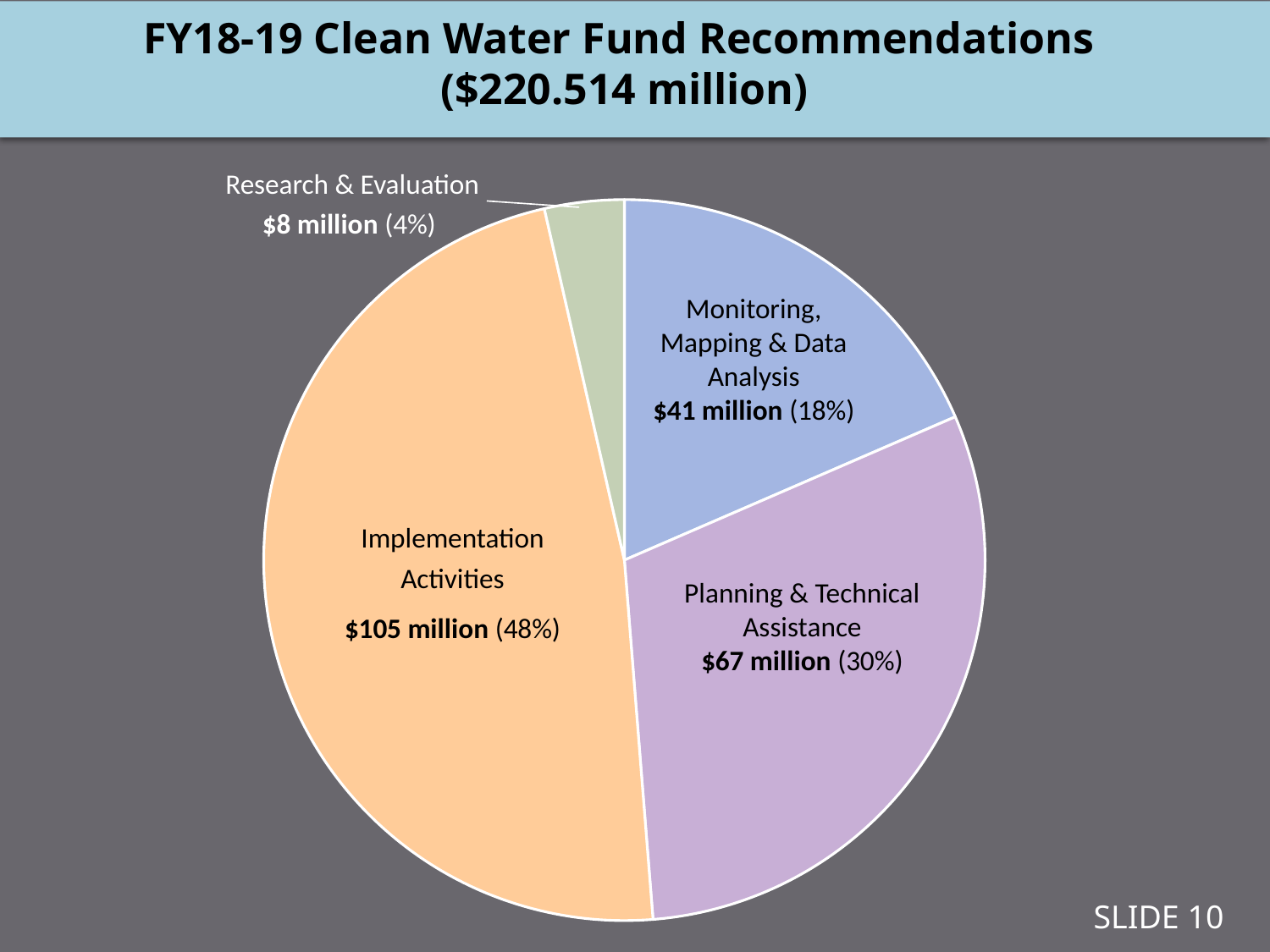
What share of the pie does Planning & Technical Assistance represent? 30% Which is larger, the value for Monitoring, Mapping & Data Analysis or the value for Research & Evaluation? Monitoring, Mapping & Data Analysis Which category has the smallest share of the pie? Research & Evaluation What is the value for Implementation Activities? $105 million What is the difference between the values for Implementation Activities and Planning & Technical Assistance? $38 million What is the value for Research & Evaluation? $8 million What is the value for Monitoring, Mapping & Data Analysis? $41 million Which category has the largest share of the pie? Implementation Activities What is the value for Planning & Technical Assistance? $67 million How many slices does the pie chart have? 4 What is the title of the chart? FY18-19 Clean Water Fund Recommendations ($220.514 million) What kind of chart is shown on the slide? pie chart